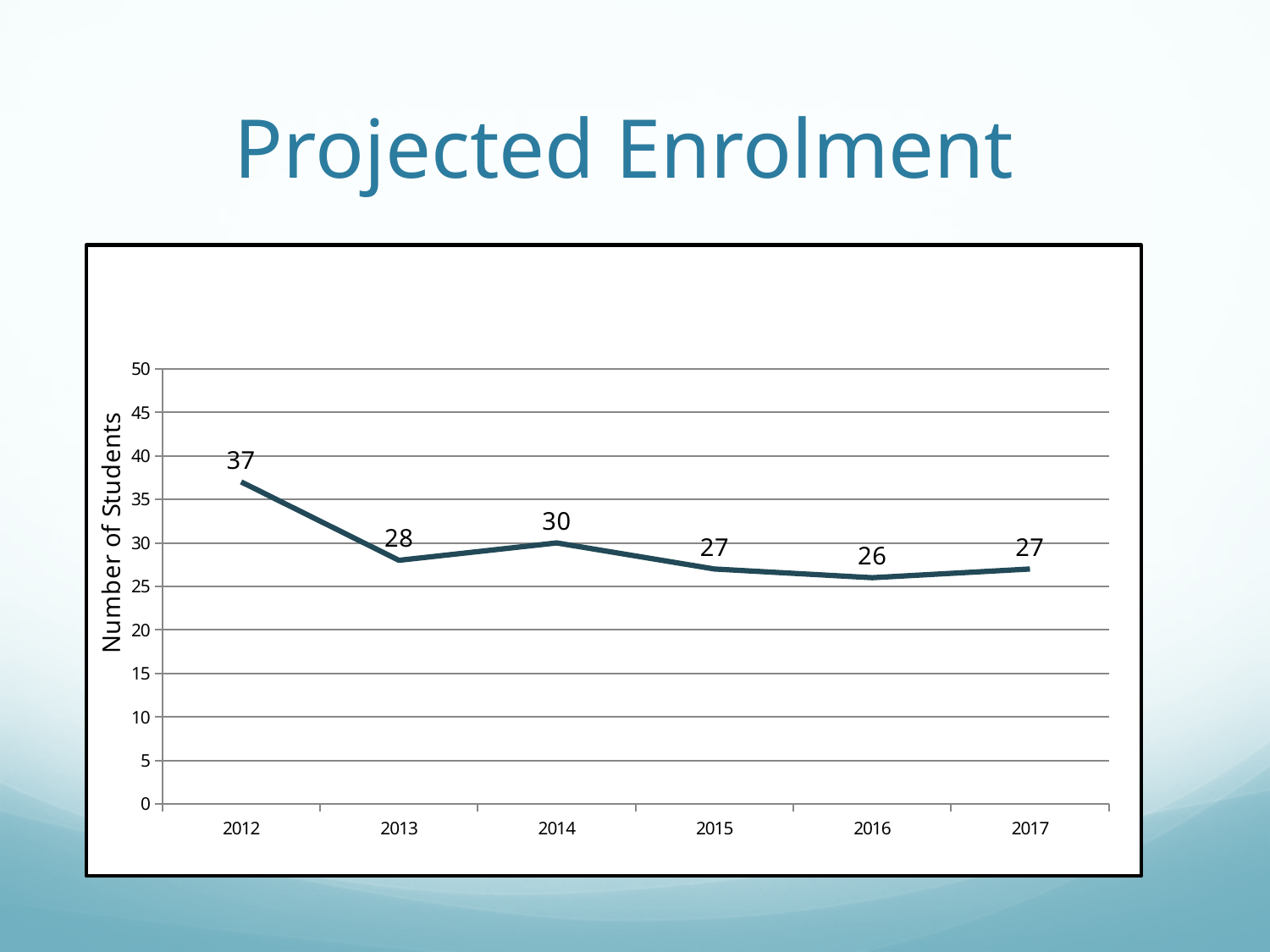
What is the difference in number of students between 2012 and 2013? 9 What is the label on the vertical axis of the chart? Number of Students Which year has the lowest projected enrolment? 2016 Which year has a larger projected enrolment, 2013 or 2014? 2014 Is the value for 2012 greater or less than 35? greater What is the number of students shown for 2014? 30 What kind of chart is shown on the slide? line chart What is the number of students shown for 2016? 26 Which year has the highest projected enrolment? 2012 What is the projected enrolment for 2012? 37 How many years are plotted on the chart? 6 What is the difference in number of students between 2014 and 2016? 4